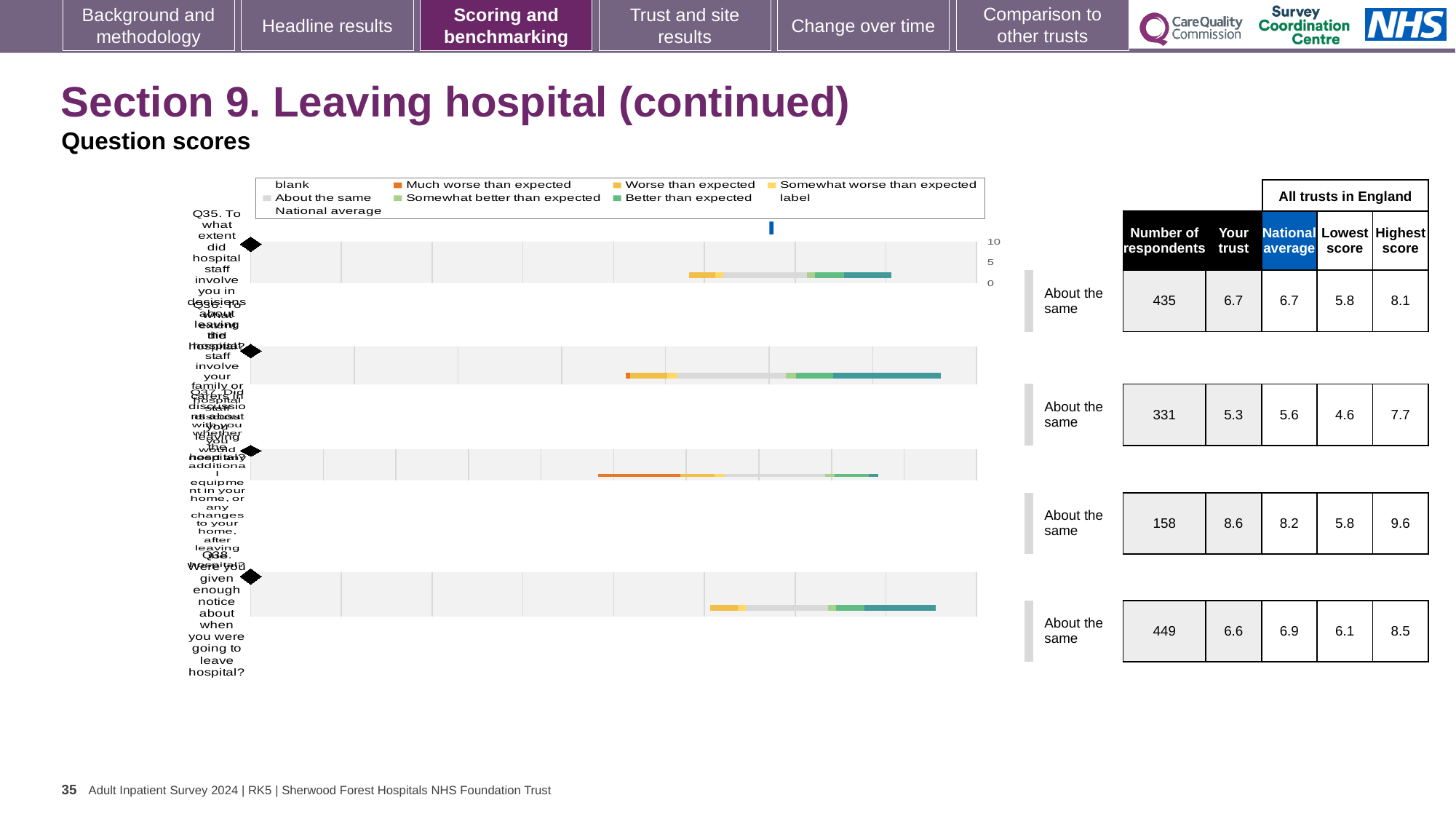
In the table beside the chart, which row has the lowest 'Your trust' score? the second row (5.3) What colour does the legend use for 'Much worse than expected'? orange What kind of chart is shown on the slide? bar chart In the table beside the chart, what is the national average for the second row? 5.6 In the table beside the chart, is the 'Your trust' score or the 'National average' larger for the last row (Q38)? National average (6.9) In the table beside the chart, what is the difference between the highest score and lowest score in the third row? 3.8 In the table beside the chart, what is the 'Your trust' score for the first row (Q35)? 6.7 In the table beside the chart, what is the number of respondents for the last row (Q38)? 449 In the table beside the chart, which row has the highest 'Your trust' score? the third row (8.6) In the table beside the chart, what is the difference between the number of respondents in the first row and the third row? 277 How many question rows (bars) does the chart show? 4 What benchmark category is shown for every row of the chart? About the same